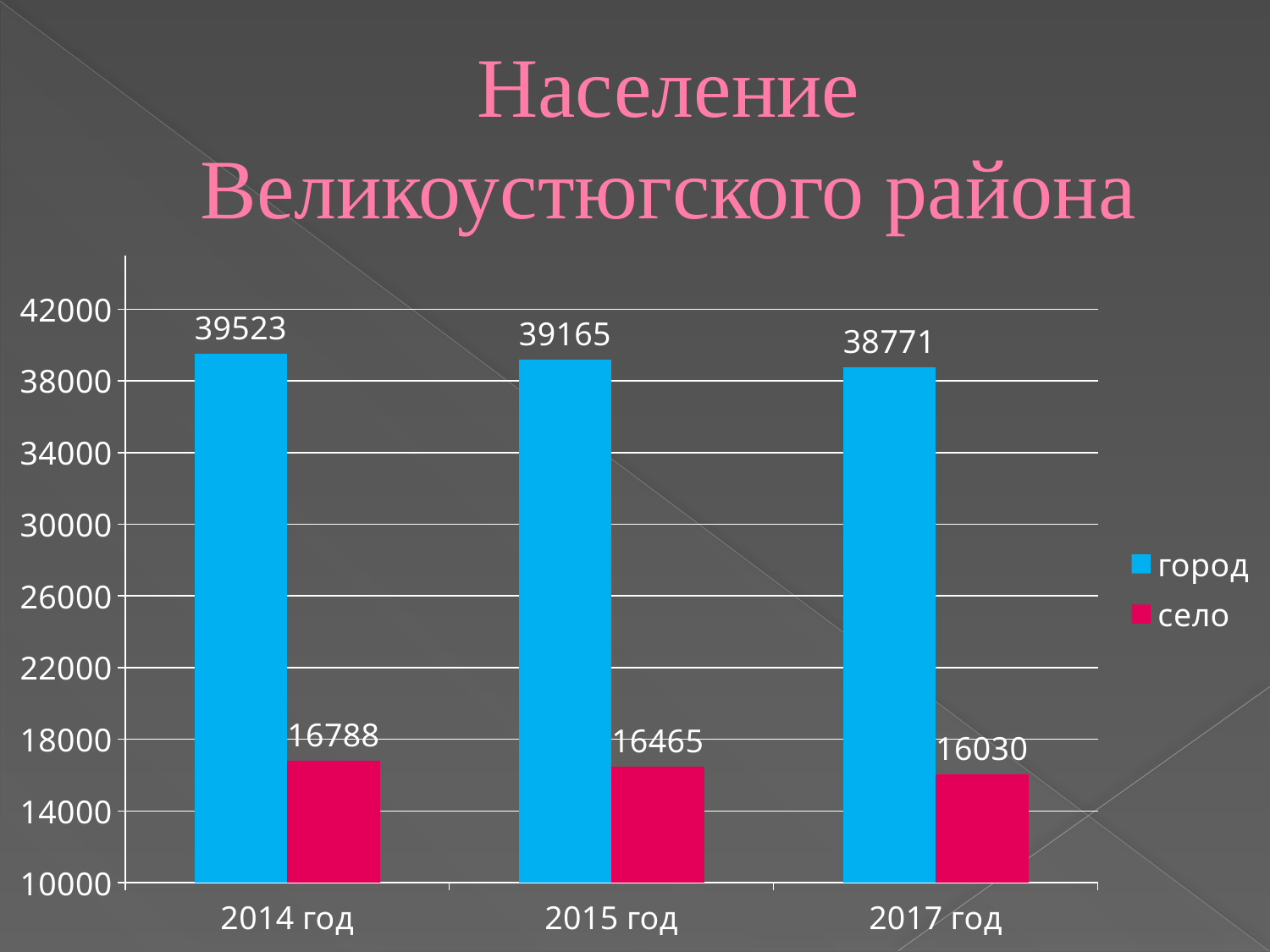
Which year has the lowest value for село? 2017 год How many series does the legend list? 2 What is the value for село in 2015 год? 16465 What is the value for село in 2017 год? 16030 Which year has the highest value for город? 2014 год What is the difference between the село values for 2014 год and 2015 год? 323 Which is larger in 2015 год, город or село? город What kind of chart is shown on the slide? bar chart How many years are shown on the x axis? 3 Do the село values rise or fall from 2014 год to 2017 год? fall What is the value for город in 2014 год? 39523 What is the difference between the город values for 2014 год and 2017 год? 752